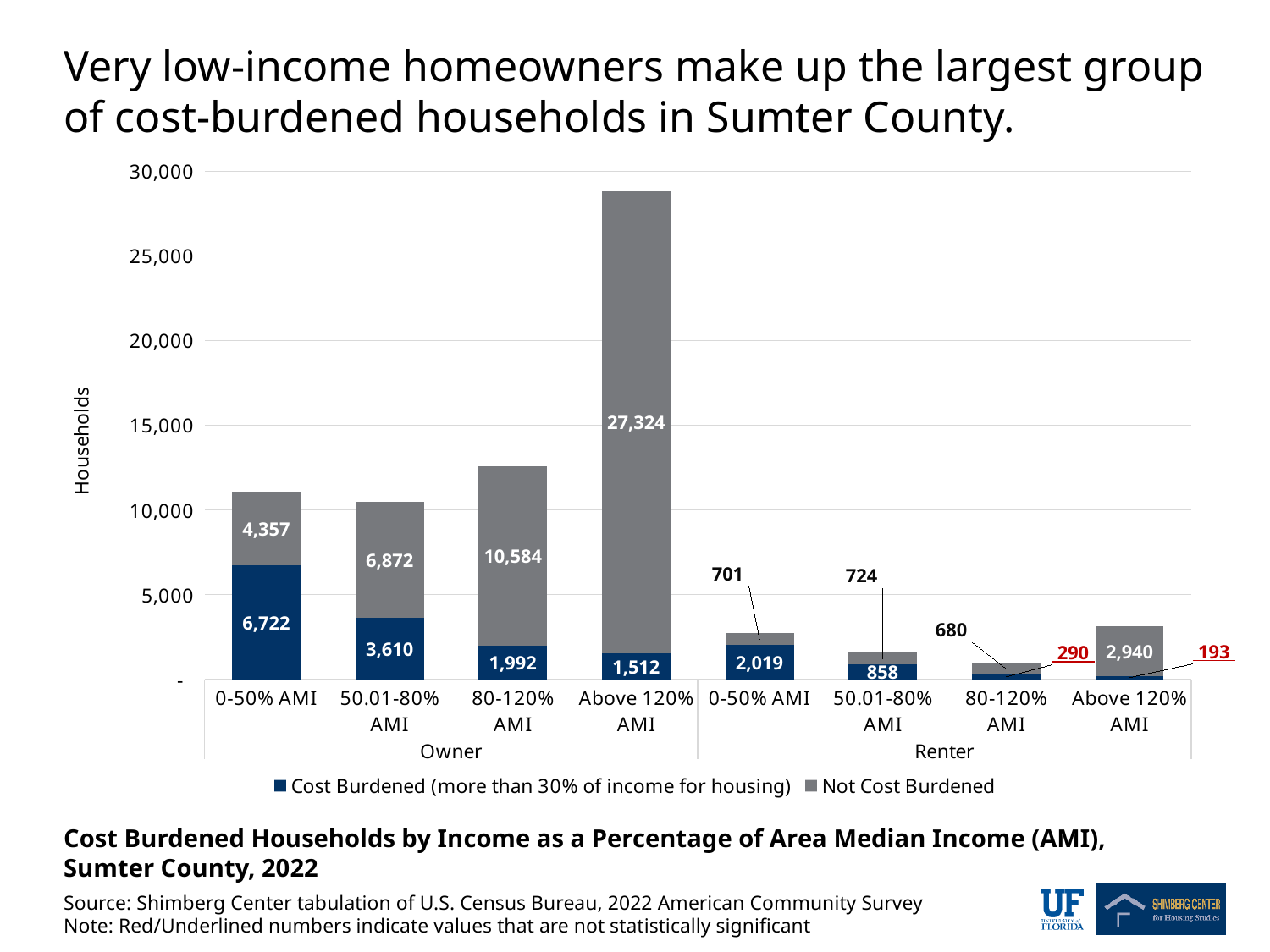
What is the total number of households in the Renter 0-50% AMI bar? 2,720 How many series does the legend list? 2 What is the number of cost-burdened owner households in the 0-50% AMI group? 6,722 Which category has the smallest number of cost-burdened households? Renter Above 120% AMI How many income categories are shown on the x axis in total? 8 Which is larger: the number of not-cost-burdened owner households in the 80-120% AMI group or in the 50.01-80% AMI group? 80-120% AMI What is the difference between cost-burdened owner households in the 0-50% AMI group and cost-burdened renter households in the 0-50% AMI group? 4,703 What kind of chart is shown on the slide? Stacked bar chart Which category has the largest number of cost-burdened households? Owner 0-50% AMI What is the number of not-cost-burdened owner households in the Above 120% AMI group? 27,324 What is the total number of households in the Owner 0-50% AMI bar? 11,079 What is the number of cost-burdened renter households in the 50.01-80% AMI group? 858